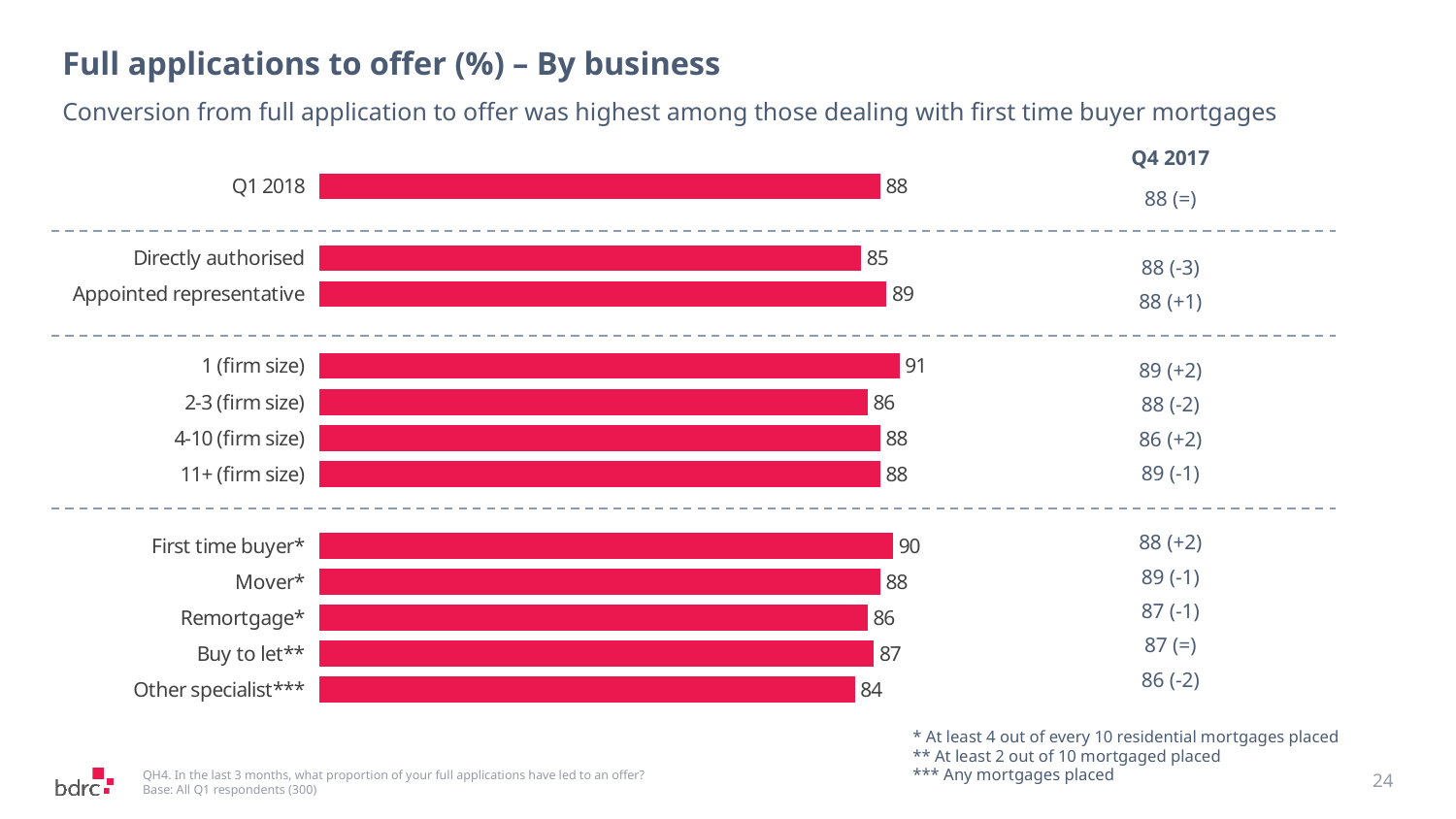
What is the value for Appointed representative? 89 What is the difference between the values for First time buyer* and Remortgage*? 4 What is the title of the slide's chart? Full applications to offer (%) – By business Which category has the lowest value? Other specialist*** How many categories are plotted in the chart? 12 What is the value for Buy to let**? 87 What is the value for Other specialist***? 84 Which category has the highest value? 1 (firm size) What is the value for Q1 2018 overall? 88 What is the difference between the values for 1 (firm size) and 2-3 (firm size)? 5 Which is larger, the value for Directly authorised or the value for Appointed representative? Appointed representative What kind of chart is shown on the slide? Bar chart